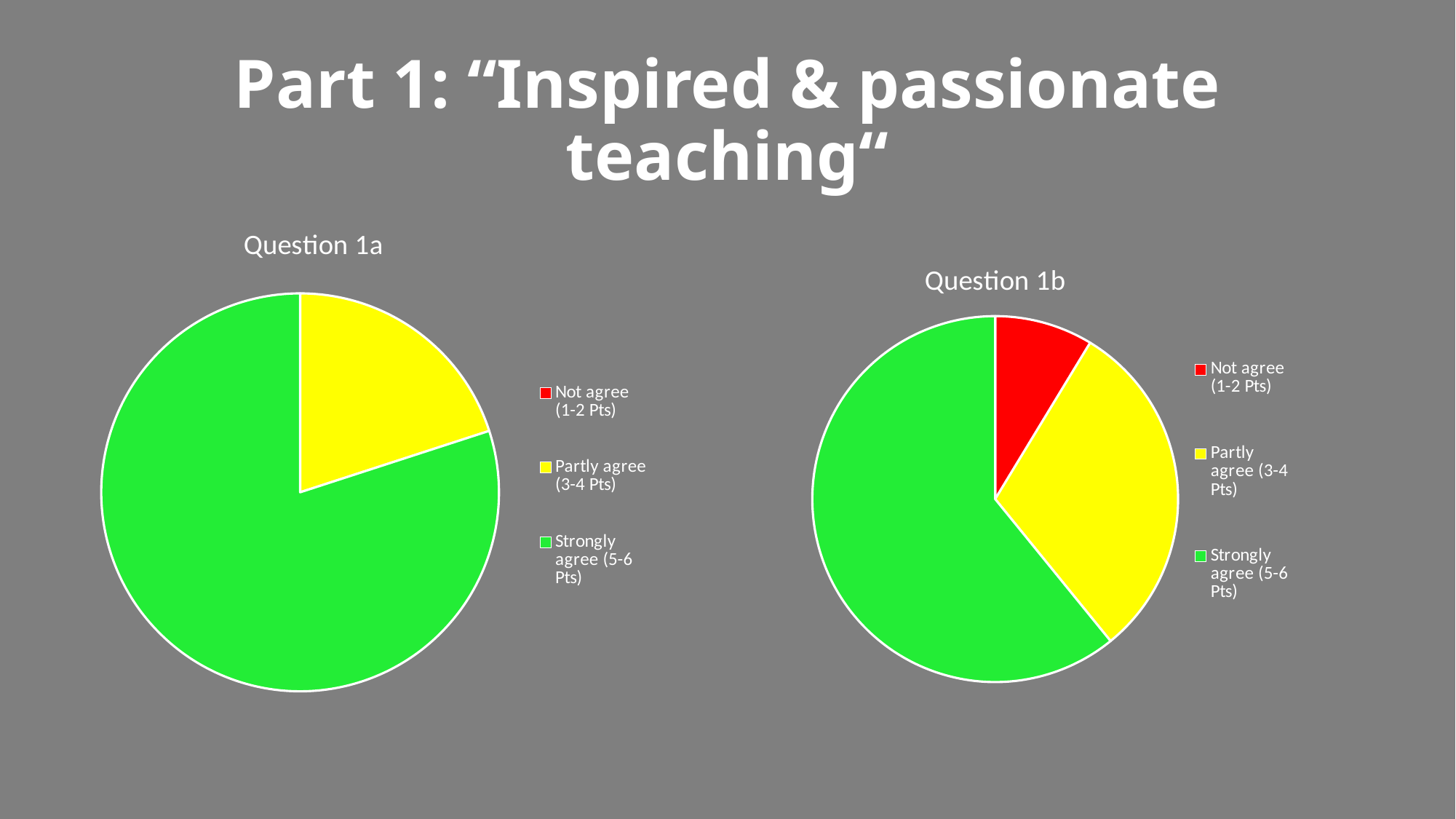
How many visible slices does the Question 1b pie have? 3 How many visible slices does the Question 1a pie have? 2 In the Question 1b chart, which category has the smallest slice? Not agree (1-2 Pts) What kind of chart is the Question 1a chart? pie chart What colour represents Not agree (1-2 Pts) in the Question 1b chart? red In the Question 1b chart, which category has the largest slice? Strongly agree (5-6 Pts) In the Question 1a chart, which category has the largest slice? Strongly agree (5-6 Pts) How many entries does the legend of the Question 1a chart list? 3 What is the title of the chart on the right of the slide? Question 1b In the Question 1a chart, which slice is larger: Strongly agree (5-6 Pts) or Partly agree (3-4 Pts)? Strongly agree (5-6 Pts) In the Question 1b chart, which slice is larger: Partly agree (3-4 Pts) or Not agree (1-2 Pts)? Partly agree (3-4 Pts) What kind of chart is the Question 1b chart? pie chart